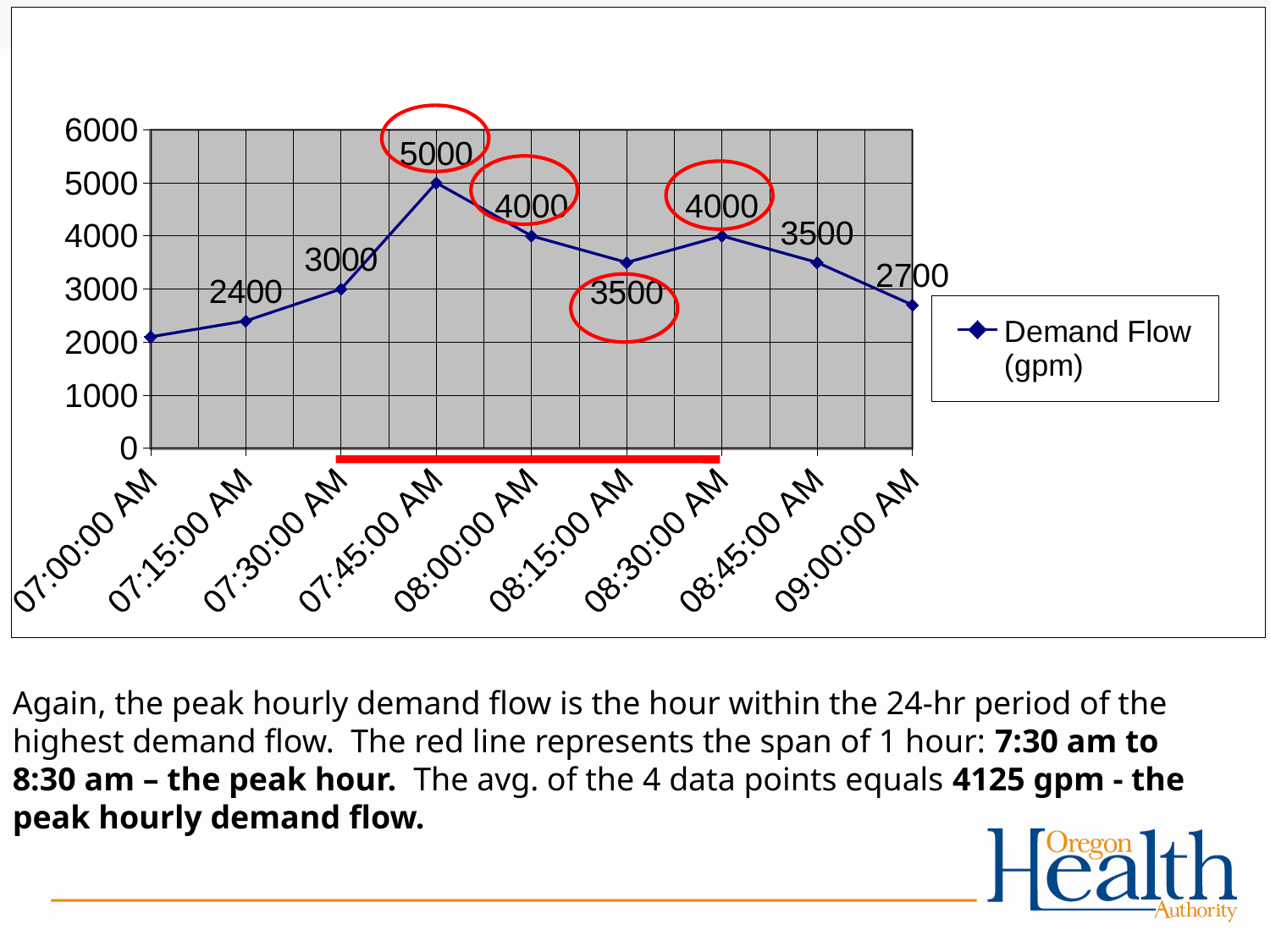
Which is larger, the Demand Flow at 08:00:00 AM or at 08:45:00 AM? 08:00:00 AM What is the Demand Flow (gpm) value at 09:00:00 AM? 2700 How many time points are plotted on the chart? 9 What kind of chart is shown on the slide? line chart How many series does the legend list? 1 Is the Demand Flow value at 07:00:00 AM greater or less than 3000? less What is the Demand Flow (gpm) value at 07:15:00 AM? 2400 At which time is the Demand Flow highest? 07:45:00 AM What is the Demand Flow (gpm) value at 07:45:00 AM? 5000 At which time is the Demand Flow lowest? 07:00:00 AM What is the difference between the Demand Flow at 07:45:00 AM and at 07:30:00 AM? 2000 What is the Demand Flow (gpm) value at 08:15:00 AM? 3500